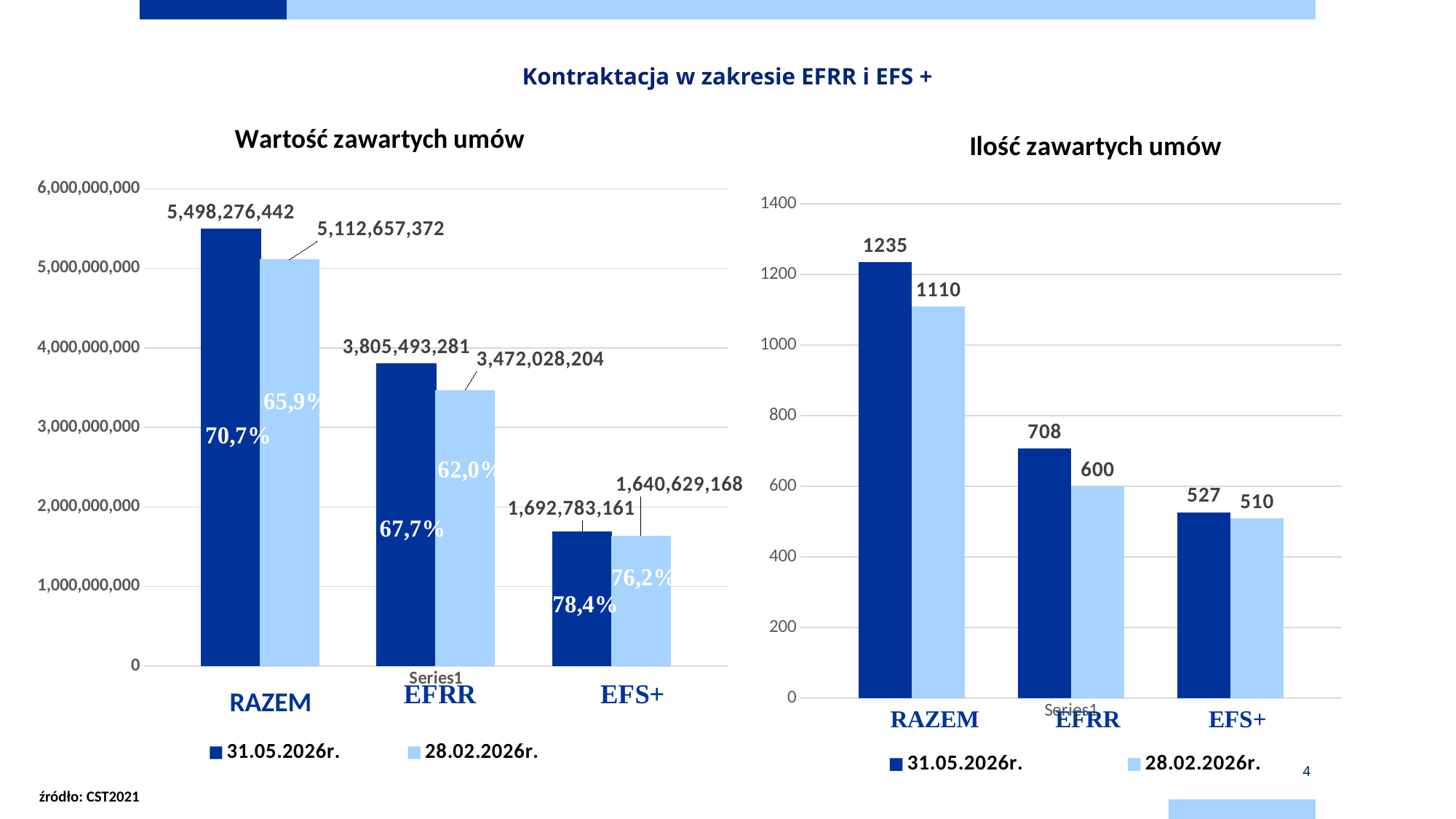
In the 'Ilość zawartych umów' chart, what is the value for EFRR for 28.02.2026r.? 600 In the 'Wartość zawartych umów' chart, which category has the lowest value for 31.05.2026r.? EFS+ In the 'Ilość zawartych umów' chart, what is the difference between the 31.05.2026r. and 28.02.2026r. values for EFS+? 17 In the 'Wartość zawartych umów' chart, what is the value for EFS+ for 31.05.2026r.? 1,692,783,161 How many series does the legend of the 'Wartość zawartych umów' chart list? 2 In the 'Ilość zawartych umów' chart, which is larger for EFRR: the 31.05.2026r. value or the 28.02.2026r. value? 31.05.2026r. In the 'Wartość zawartych umów' chart, what is the value for RAZEM for 28.02.2026r.? 5,112,657,372 In the 'Wartość zawartych umów' chart, what percentage label is shown inside the 31.05.2026r. bar for EFS+? 78,4% What kind of chart is 'Ilość zawartych umów'? bar chart In the 'Ilość zawartych umów' chart, what is the value for RAZEM for 31.05.2026r.? 1235 In the 'Ilość zawartych umów' chart, what is the difference between the 31.05.2026r. and 28.02.2026r. values for RAZEM? 125 In the 'Ilość zawartych umów' chart, which category has the highest value for 28.02.2026r.? RAZEM